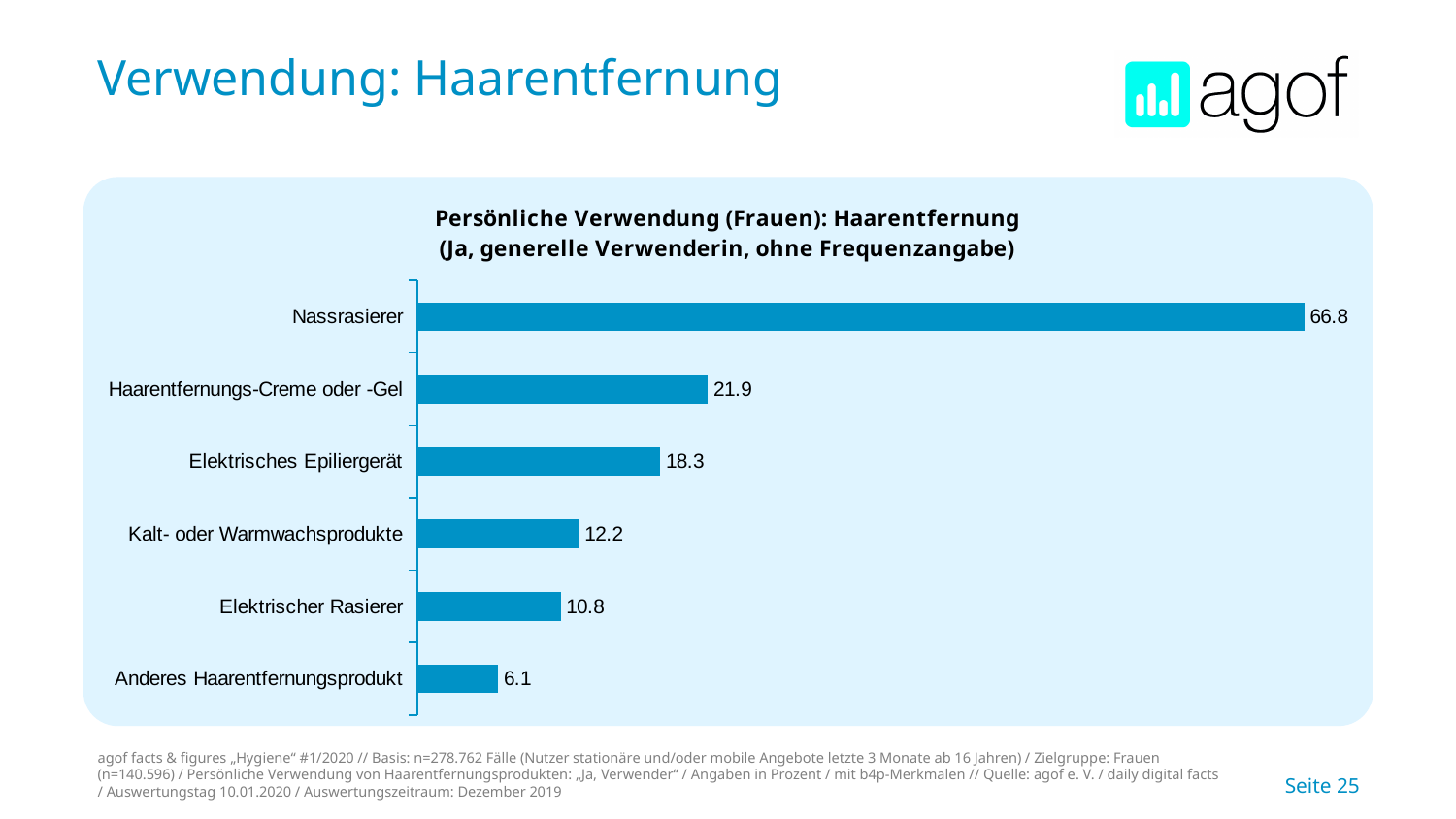
What is the value for Elektrisches Epiliergerät? 18.3 Which is larger, the value for Elektrisches Epiliergerät or the value for Elektrischer Rasierer? Elektrisches Epiliergerät What kind of chart is shown on the slide? Bar chart What is the difference between the values for Kalt- oder Warmwachsprodukte and Elektrischer Rasierer? 1.4 How many categories are shown in the chart? 6 What is the value for Kalt- oder Warmwachsprodukte? 12.2 Which category has the highest value? Nassrasierer What is the value for Elektrischer Rasierer? 10.8 What is the value for Nassrasierer? 66.8 What is the difference between the values for Nassrasierer and Haarentfernungs-Creme oder -Gel? 44.9 Which category has the lowest value? Anderes Haarentfernungsprodukt What is the value for Haarentfernungs-Creme oder -Gel? 21.9